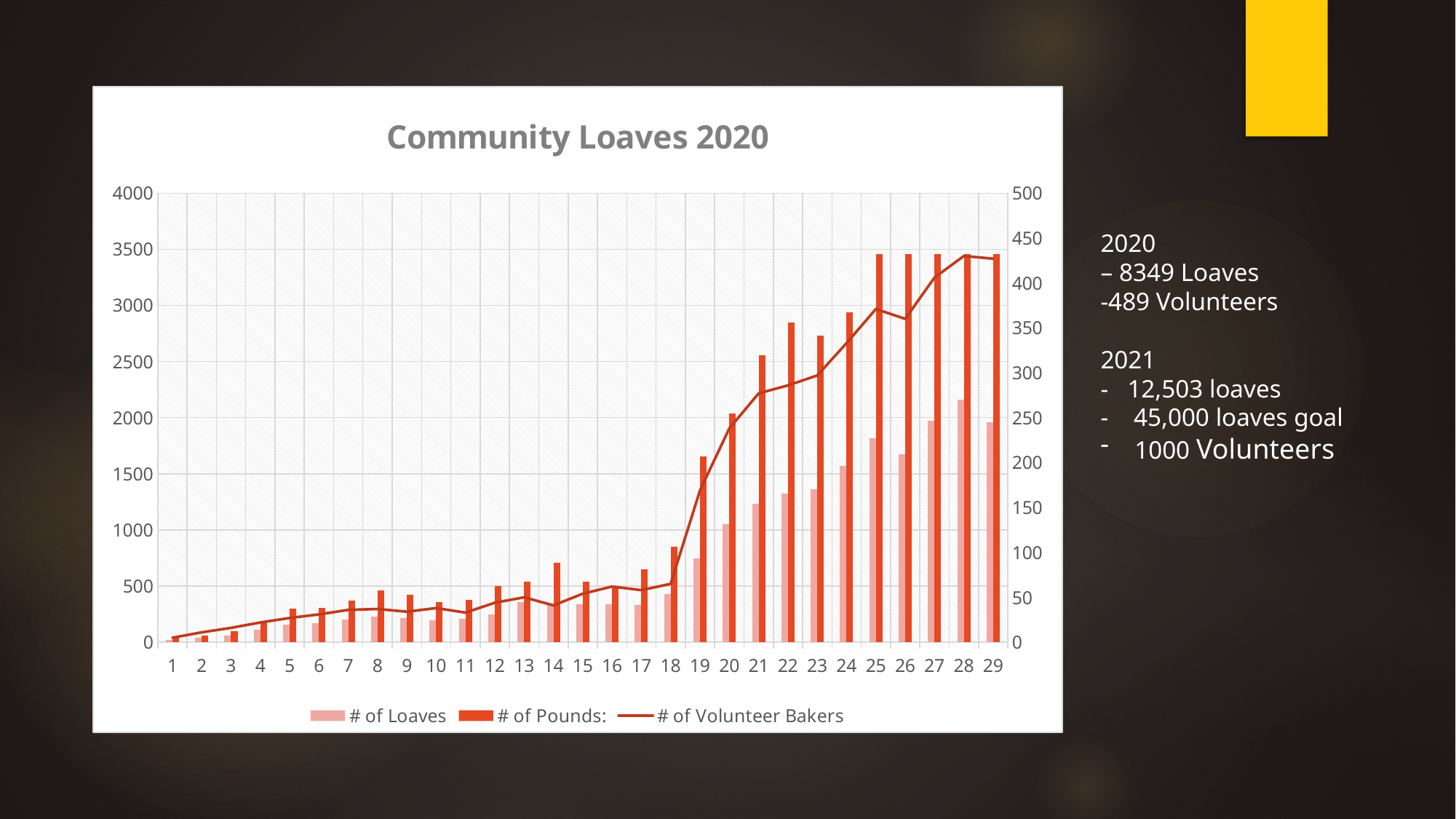
What is the title of the chart? Community Loaves 2020 Which is larger, # of Pounds at category 14 or at category 13? Category 14 Is the value of # of Loaves at category 19 greater or less than 1000? less Which category has the lowest value for # of Pounds? 1 Is the value of # of Loaves at category 28 greater or less than 2000? greater What kind of chart is this? Combined bar and line chart Which series is drawn as a line rather than bars? # of Volunteer Bakers Which category has the highest value for # of Loaves? 28 Is the value of # of Pounds at category 25 greater or less than 3000? greater How many categories are shown along the x axis? 29 How many series does the legend list? 3